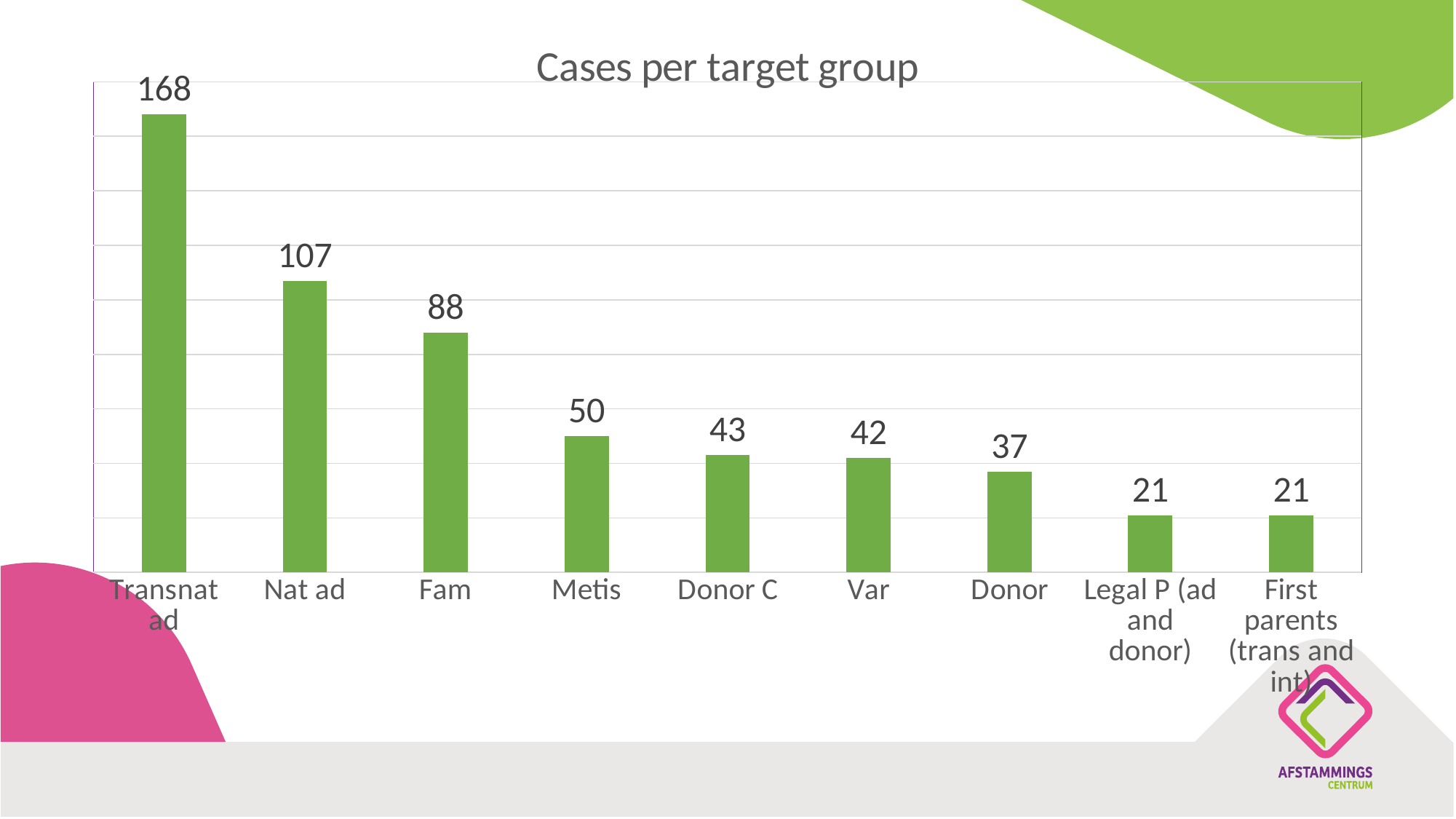
What is the difference between the values for Fam and Metis? 38 How many target groups are shown in the chart? 9 Which target group has the highest number of cases? Transnat ad What is the value for Transnat ad? 168 What is the title of the chart? Cases per target group Do the values rise or fall from left to right along the x axis? fall Which is larger, the value for Nat ad or the value for Fam? Nat ad What kind of chart is shown on the slide? bar chart What is the value for Metis? 50 What is the value for Legal P (ad and donor)? 21 What is the difference between the values for Transnat ad and Nat ad? 61 What is the value for Donor? 37